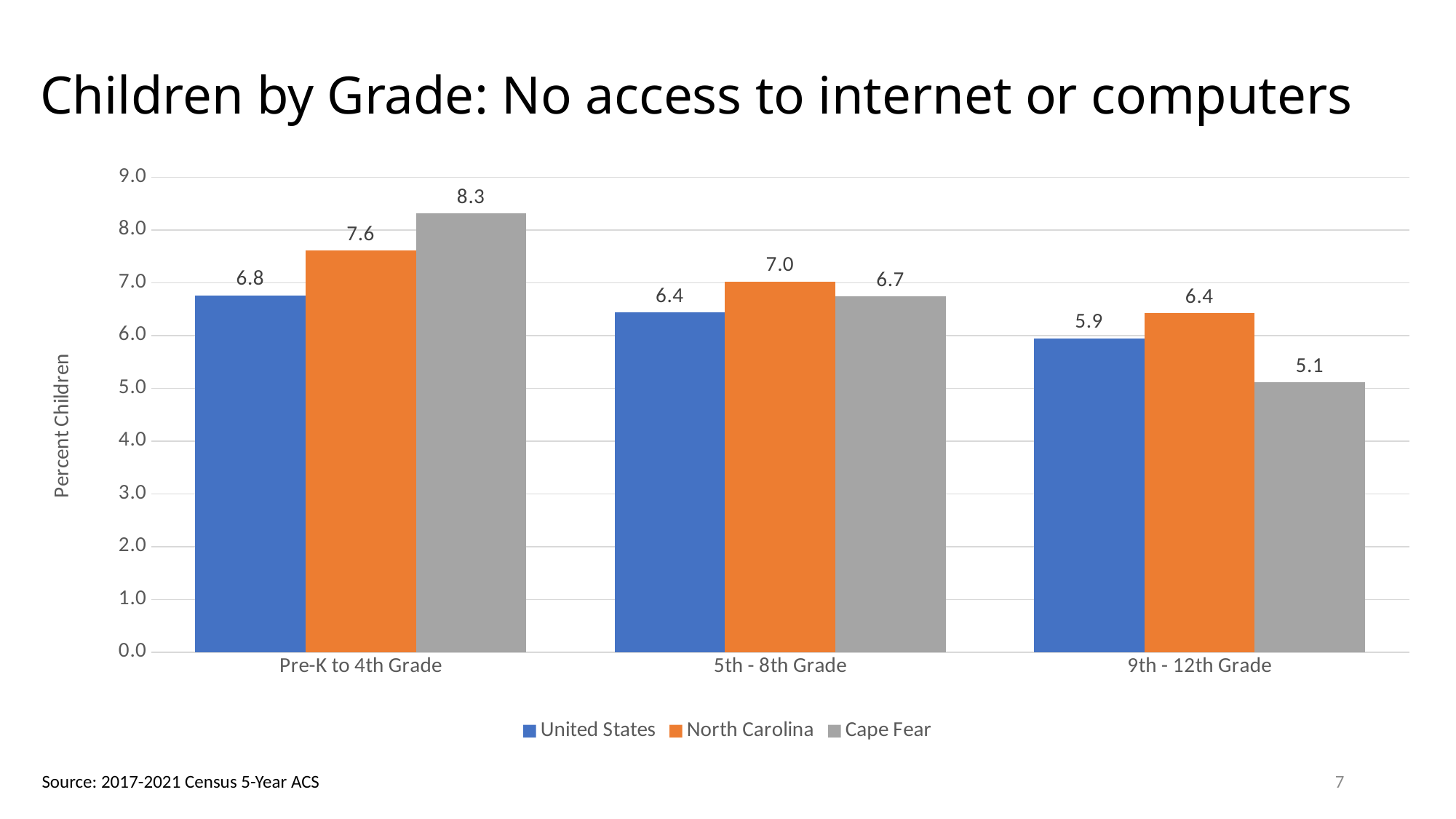
Which series has the highest value in the Pre-K to 4th Grade category? Cape Fear How many series does the legend list? 3 What is the value for Cape Fear in the Pre-K to 4th Grade category? 8.3 Is the value for Cape Fear in the 9th - 12th Grade category greater or less than 6.0? less How many grade categories are shown on the x axis? 3 What is the difference between the Cape Fear values for Pre-K to 4th Grade and 9th - 12th Grade? 3.2 What is the value for North Carolina in the 5th - 8th Grade category? 7.0 Do the United States values rise or fall from Pre-K to 4th Grade to 9th - 12th Grade? fall What is the value for United States in the 9th - 12th Grade category? 5.9 What kind of chart is shown on the slide? bar chart Which is larger in the 5th - 8th Grade category: North Carolina or Cape Fear? North Carolina Which series has the lowest value in the 9th - 12th Grade category? Cape Fear